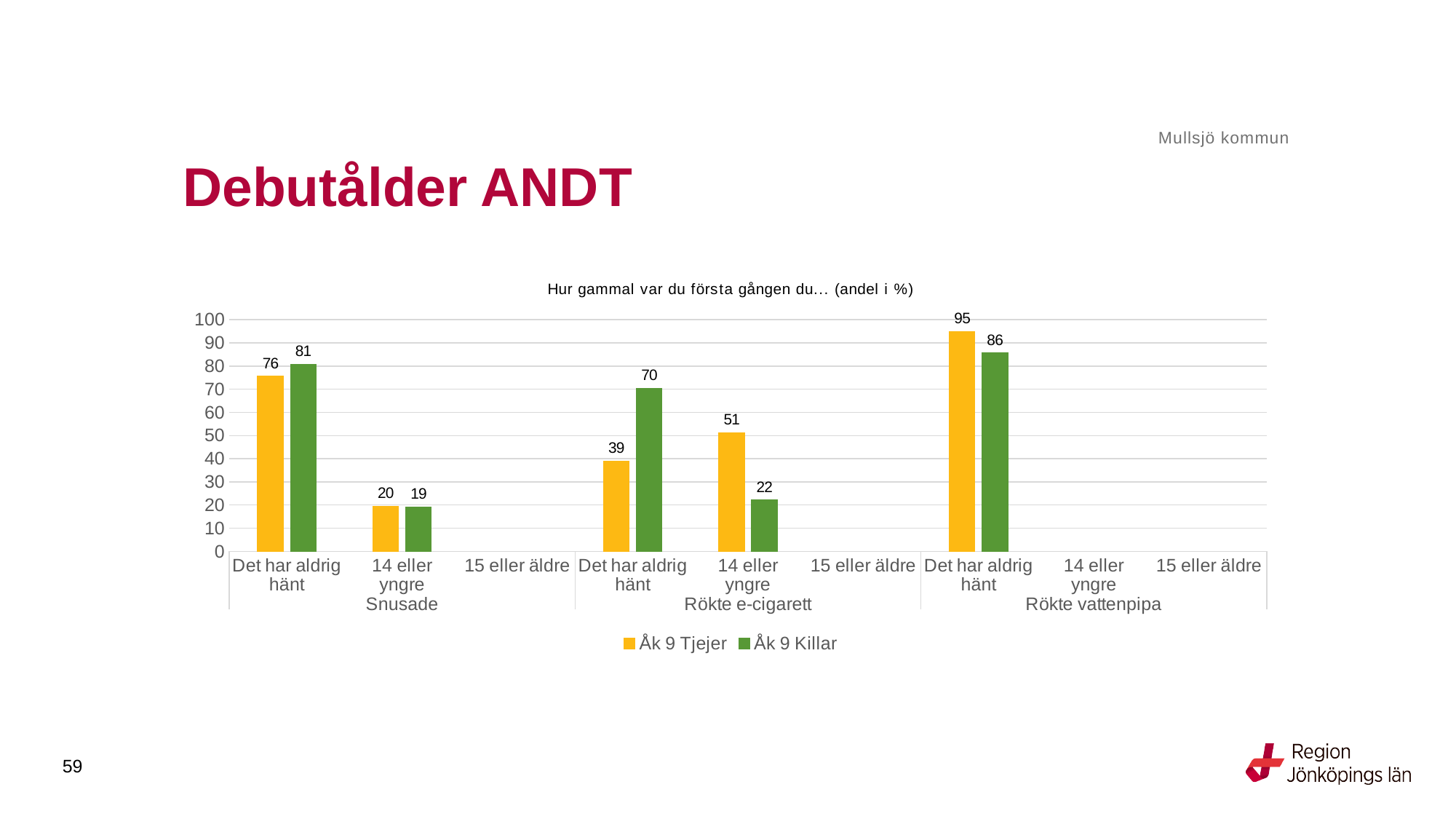
How many series does the legend list? 2 Is the value for Åk 9 Tjejer for 'Det har aldrig hänt' under Rökte vattenpipa greater or less than 90? greater What is the value for Åk 9 Tjejer for 'Det har aldrig hänt' under Snusade? 76 What kind of chart is shown on the slide? Bar chart Which series has the lowest value for '14 eller yngre' under Snusade? Åk 9 Killar For '14 eller yngre' under Rökte e-cigarett, which series has the larger value, Åk 9 Tjejer or Åk 9 Killar? Åk 9 Tjejer What is the value for Åk 9 Killar for 'Det har aldrig hänt' under Rökte e-cigarett? 70 What is the difference between Åk 9 Killar and Åk 9 Tjejer for 'Det har aldrig hänt' under Rökte e-cigarett? 31 What is the value for Åk 9 Killar for 'Det har aldrig hänt' under Rökte vattenpipa? 86 What is the value for Åk 9 Tjejer for '14 eller yngre' under Rökte e-cigarett? 51 What is the title of the chart? Hur gammal var du första gången du… (andel i %) Which bar has the highest value in the chart? Åk 9 Tjejer, Det har aldrig hänt (Rökte vattenpipa)